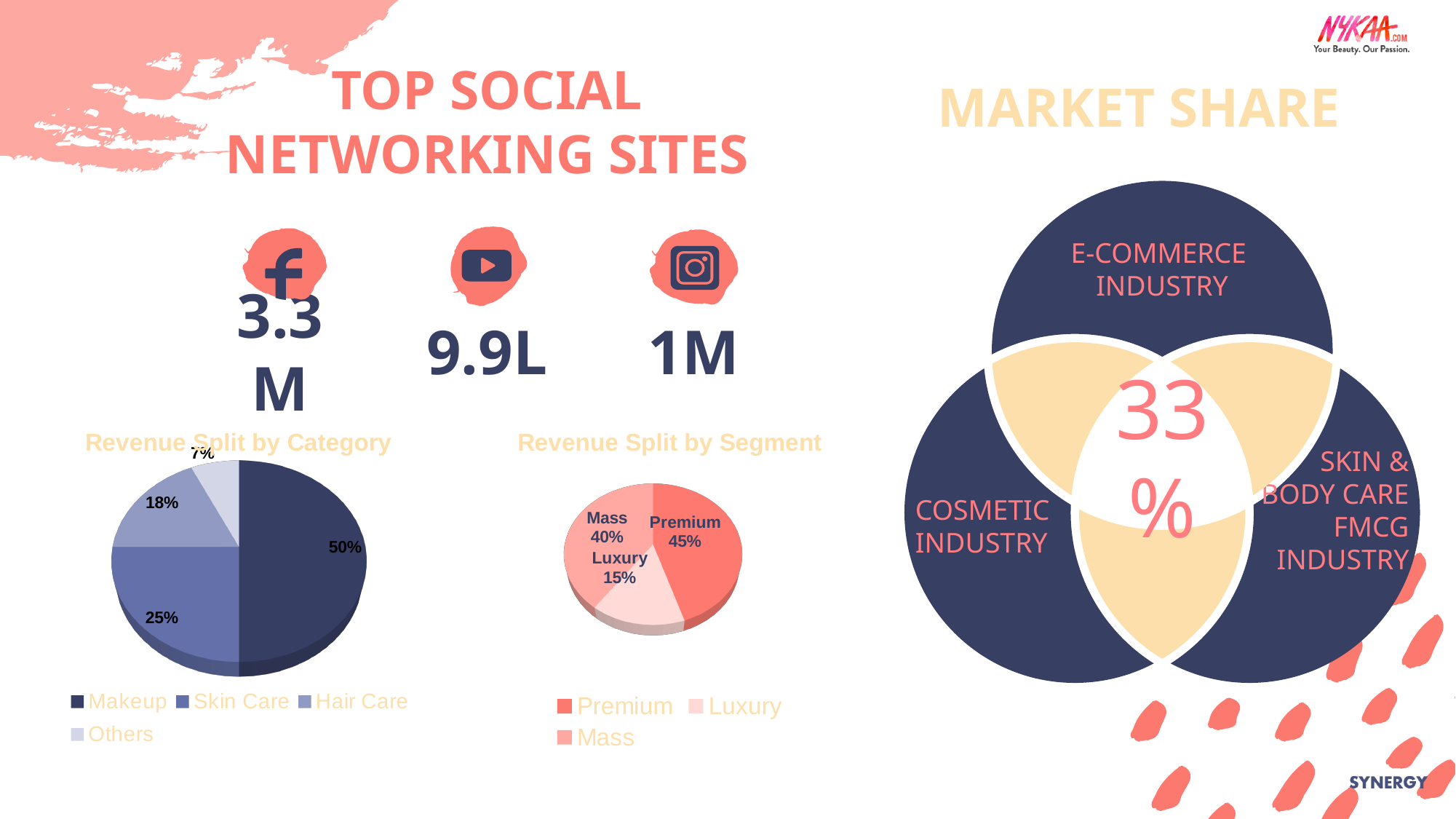
In the 'Revenue Split by Segment' chart, what share does Luxury have? 15% In the 'Revenue Split by Segment' chart, what share does Premium have? 45% In the 'Revenue Split by Category' chart, what share does Makeup have? 50% In the 'Revenue Split by Segment' chart, which segment has the largest share? Premium In the 'Revenue Split by Category' chart, what is the difference between the Skin Care and Hair Care shares? 7% What type of chart is 'Revenue Split by Segment'? Pie chart In the 'Revenue Split by Category' chart, which category has the smallest share? Others In the 'Revenue Split by Segment' chart, what is the difference between the Premium and Mass shares? 5% In the 'Revenue Split by Category' chart, which category has the largest share? Makeup In the 'Revenue Split by Category' chart, how many categories does the legend list? 4 In the 'Revenue Split by Category' chart, what share does Hair Care have? 18% In the 'Revenue Split by Segment' chart, which is larger, Mass or Luxury? Mass